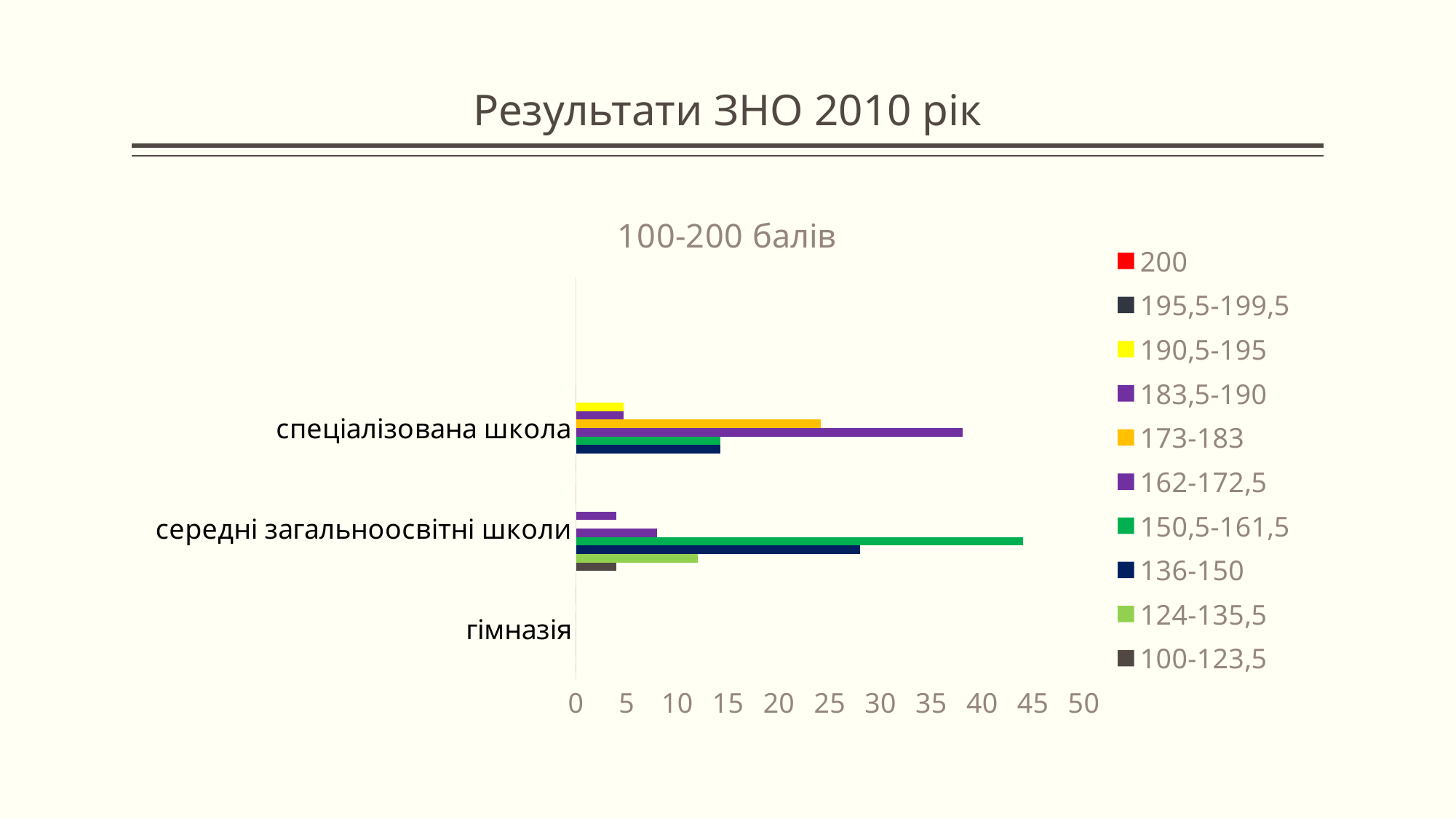
Is the value for 173-183 for спеціалізована школа greater or less than 20? greater Is the value for 136-150 for середні загальноосвітні школи greater or less than 25? greater How many series does the legend list? 10 Is the value for 124-135,5 for середні загальноосвітні школи greater or less than 15? less How many categories are shown on the vertical axis of the chart? 3 What is the title of the chart? 100-200 балів Which is larger: the value for 150,5-161,5 for середні загальноосвітні школи or for спеціалізована школа? середні загальноосвітні школи What kind of chart is shown on the slide? bar chart Which series has the longest bar for середні загальноосвітні школи? 150,5-161,5